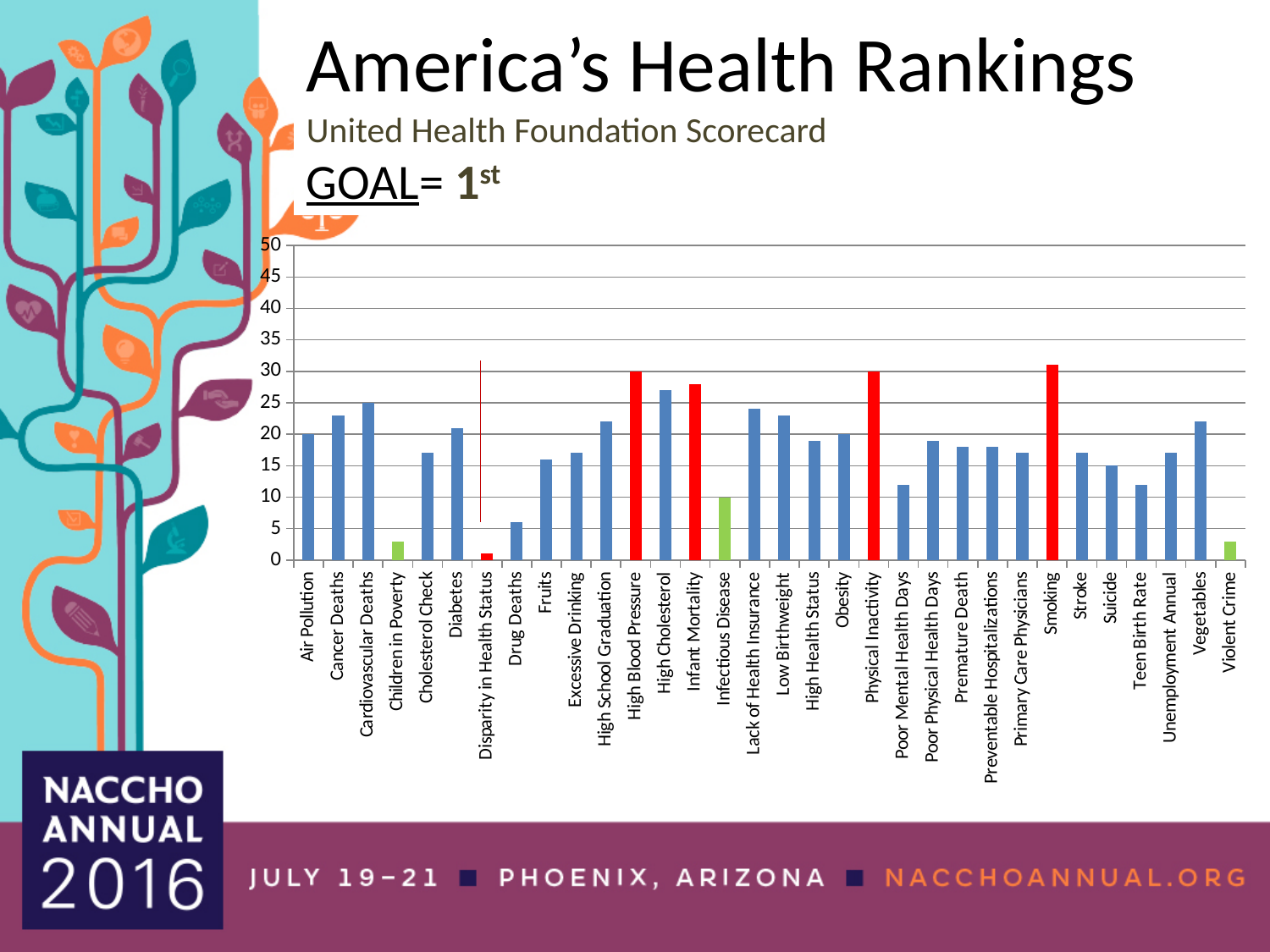
Is the value for High Cholesterol greater or less than 25? greater Is the value for Cancer Deaths greater or less than 20? greater What is the value for Air Pollution? 20 What is the value for Infectious Disease? 10 Is the value for Drug Deaths greater or less than 10? less What is the value for Cardiovascular Deaths? 25 What kind of chart is shown on the slide? bar chart Which category has the lowest value in the chart? Disparity in Health Status Which is larger, the value for Vegetables or the value for Suicide? Vegetables What is the difference between the values for Cardiovascular Deaths and Air Pollution? 5 What colour is the bar for Smoking? red How many categories are plotted along the x axis of the chart? 32